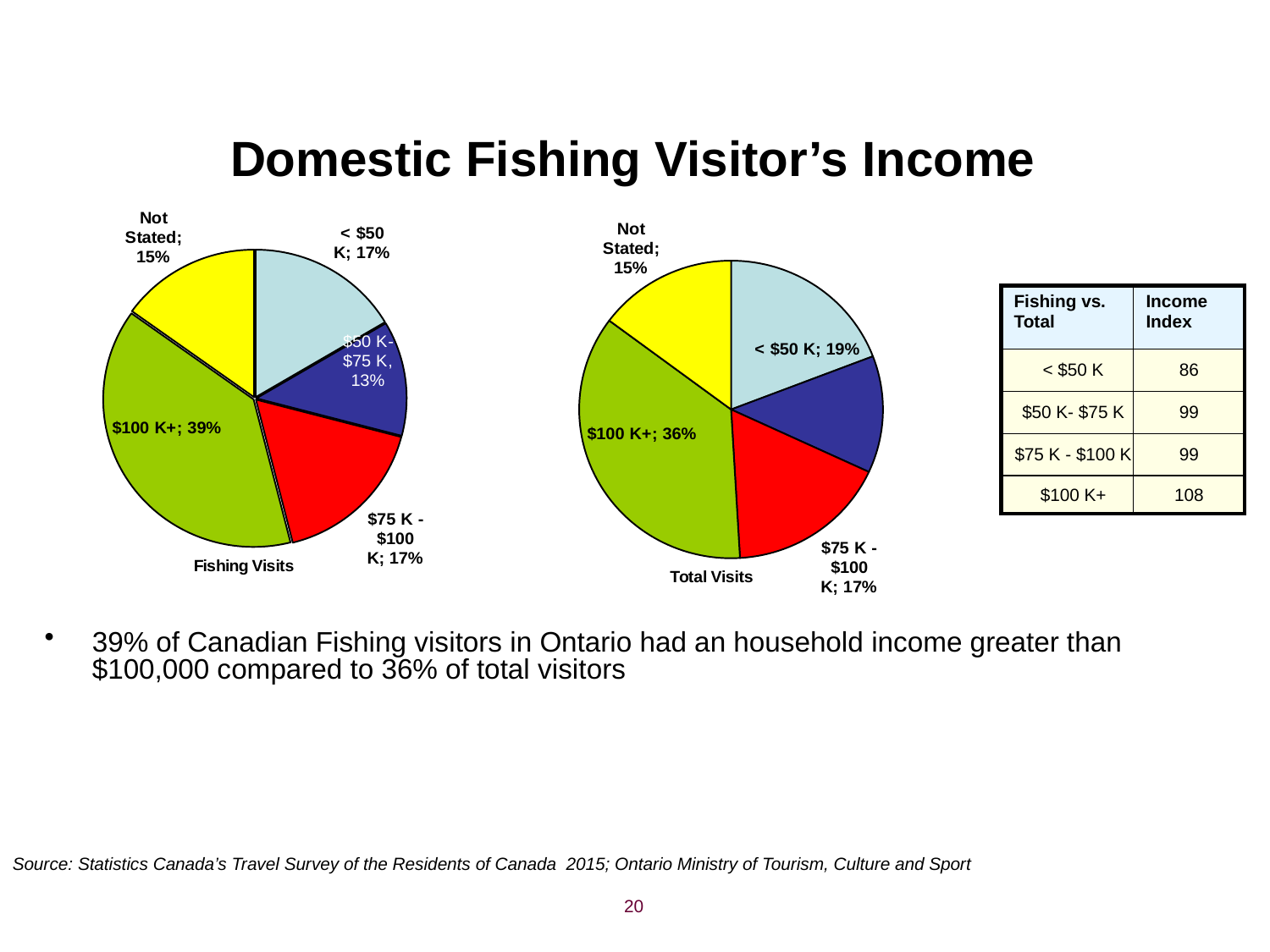
What type of chart is used to show the Total Visits income breakdown? Pie chart In the Fishing Visits pie chart, which income category has the largest share? $100 K+ In the Fishing Visits pie chart, what share of visitors had a household income of $100 K+? 39% In the Fishing Visits pie chart, what percentage of visitors fall in the $50 K-$75 K income group? 13% In the Fishing Visits pie chart, which labelled income category has the smallest share? $50 K-$75 K How many slices does the Fishing Visits pie chart have? 5 In the Total Visits pie chart, what percentage of visitors had an income of less than $50 K? 19% What colour is the $100 K+ slice in the Fishing Visits pie chart? Green In the Fishing Visits pie chart, what percentage of visitors did not state their income? 15% What is the difference between the $100 K+ share in the Fishing Visits pie chart and the $100 K+ share in the Total Visits pie chart? 3 percentage points In the Total Visits pie chart, what share of visitors had a household income of $100 K+? 36% Which is larger: the < $50 K share in the Fishing Visits pie chart or the < $50 K share in the Total Visits pie chart? Total Visits